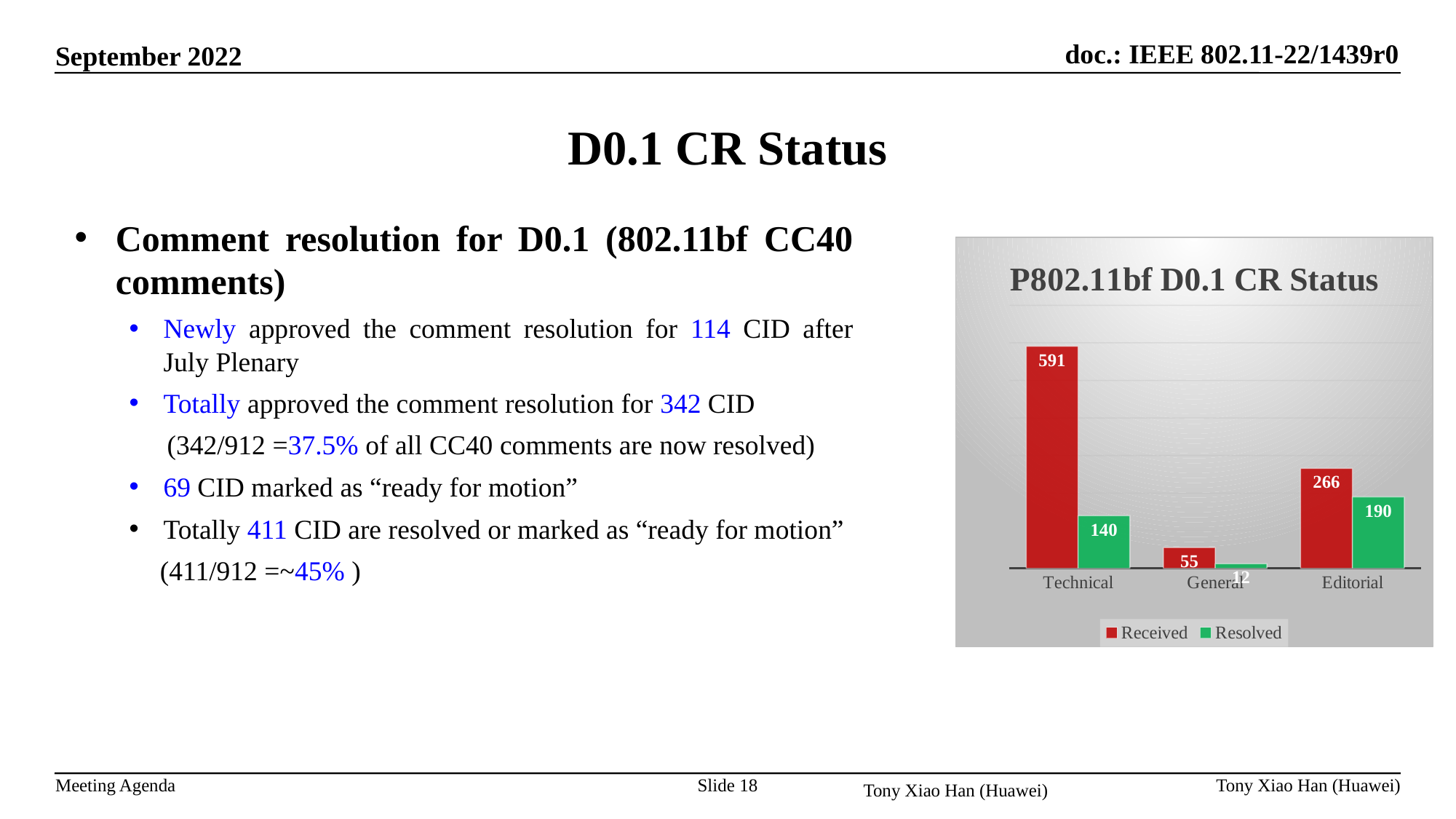
Which category has the highest Received value? Technical What is the Resolved value for Editorial? 190 How many categories are shown on the x axis of the chart? 3 Which series is shown in green in the chart? Resolved What is the title of the chart? P802.11bf D0.1 CR Status Which is larger for Editorial, Received or Resolved? Received What type of chart is shown on the slide? bar chart How many series does the chart legend list? 2 Which category has the lowest Resolved value? General What is the Received value for General? 55 What is the difference between Received and Resolved for Technical? 451 What is the Received value for Technical? 591